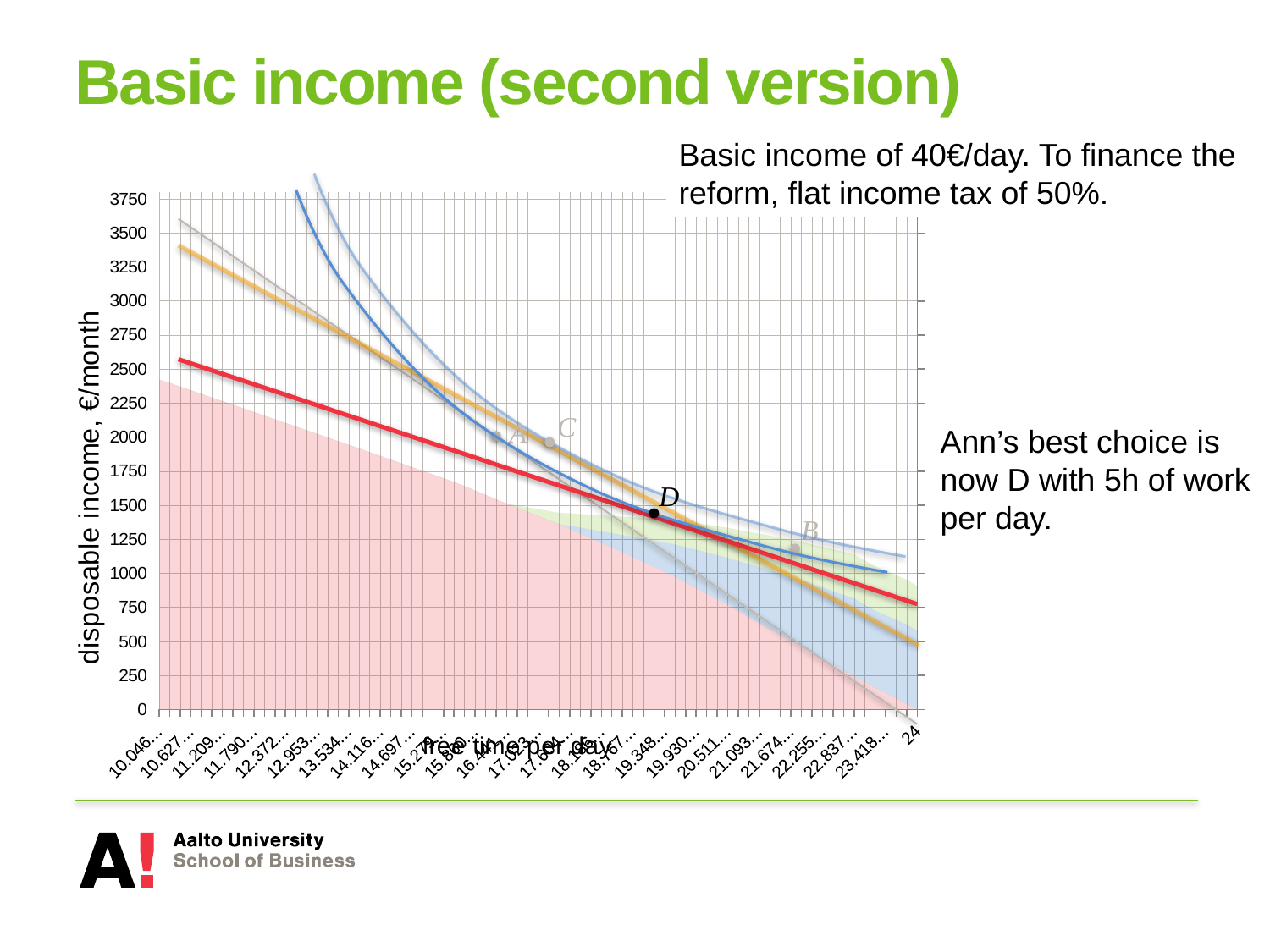
What is the title of the vertical axis of the chart? disposable income, €/month What is the title of the horizontal axis of the chart? free time per day Which point has the higher disposable income, D or B? D What is the highest tick value shown on the vertical axis? 3750 Is the disposable income at point D greater or less than 1250? greater What is the last label shown on the horizontal axis? 24 Is the disposable income at point B greater or less than 1250? less Does the red line rise or fall as free time per day increases along the x axis? fall Is the disposable income at point D greater or less than 1500? less What kind of chart is shown on the slide? area chart Which point has the higher disposable income, C or D? C